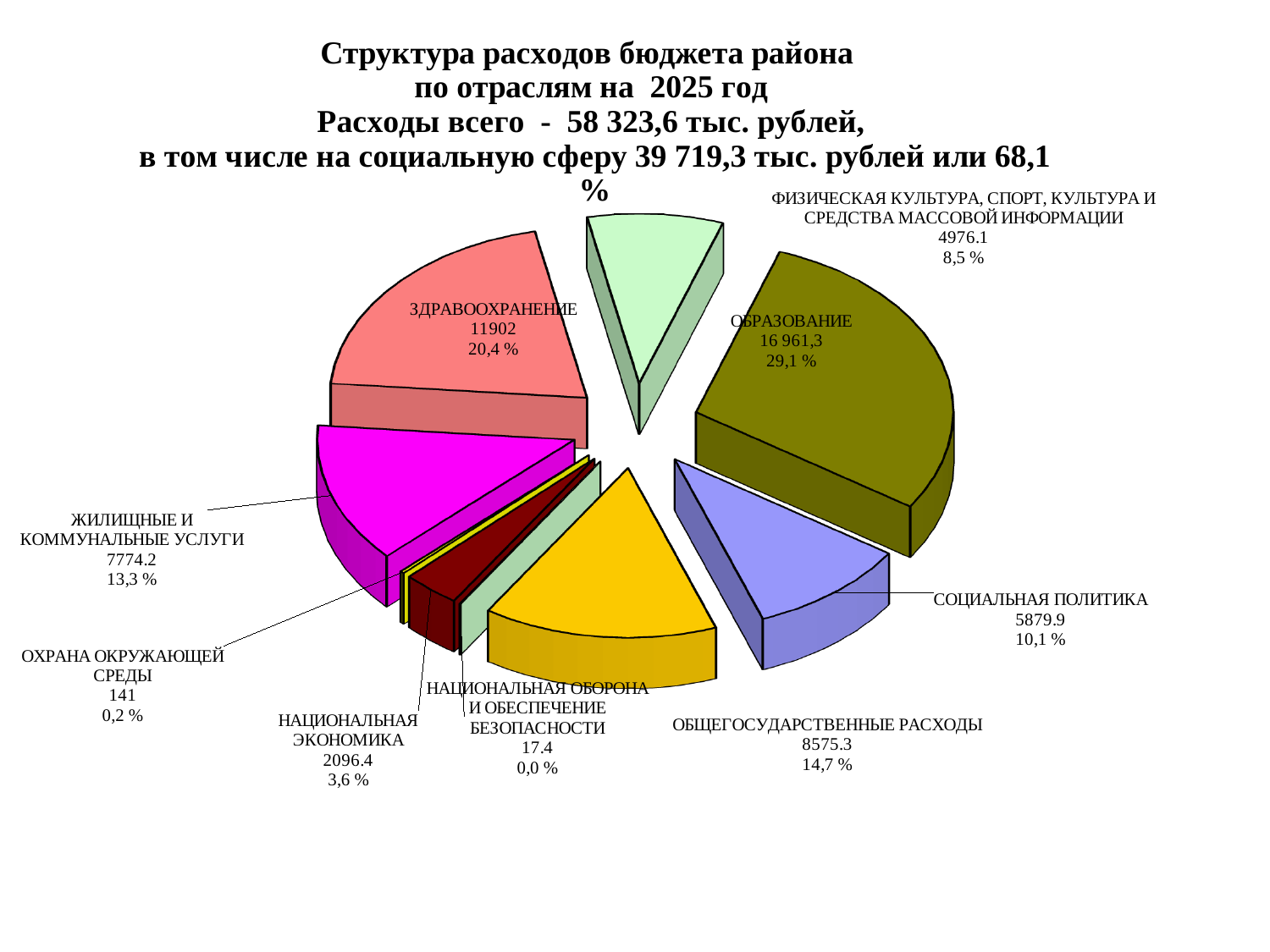
What is the difference between the values for ЗДРАВООХРАНЕНИЕ (11902) and ОБЩЕГОСУДАРСТВЕННЫЕ РАСХОДЫ (8575.3)? 3326.7 What percentage share is shown for ОБЩЕГОСУДАРСТВЕННЫЕ РАСХОДЫ? 14,7 % What percentage share is shown for ЖИЛИЩНЫЕ И КОММУНАЛЬНЫЕ УСЛУГИ? 13,3 % According to the chart title, what is the total expenditure (Расходы всего)? 58 323,6 тыс. рублей What is the value shown for ОБРАЗОВАНИЕ? 16 961,3 What is the value shown for СОЦИАЛЬНАЯ ПОЛИТИКА? 5879.9 Which category has the smallest value in the pie chart? НАЦИОНАЛЬНАЯ ОБОРОНА И ОБЕСПЕЧЕНИЕ БЕЗОПАСНОСТИ What is the value shown for ЗДРАВООХРАНЕНИЕ? 11902 Which is larger: ЗДРАВООХРАНЕНИЕ or ОБЩЕГОСУДАРСТВЕННЫЕ РАСХОДЫ? ЗДРАВООХРАНЕНИЕ How many categories (slices) does the pie chart have? 9 Which category has the largest slice of the pie? ОБРАЗОВАНИЕ What kind of chart is shown on the slide? pie chart